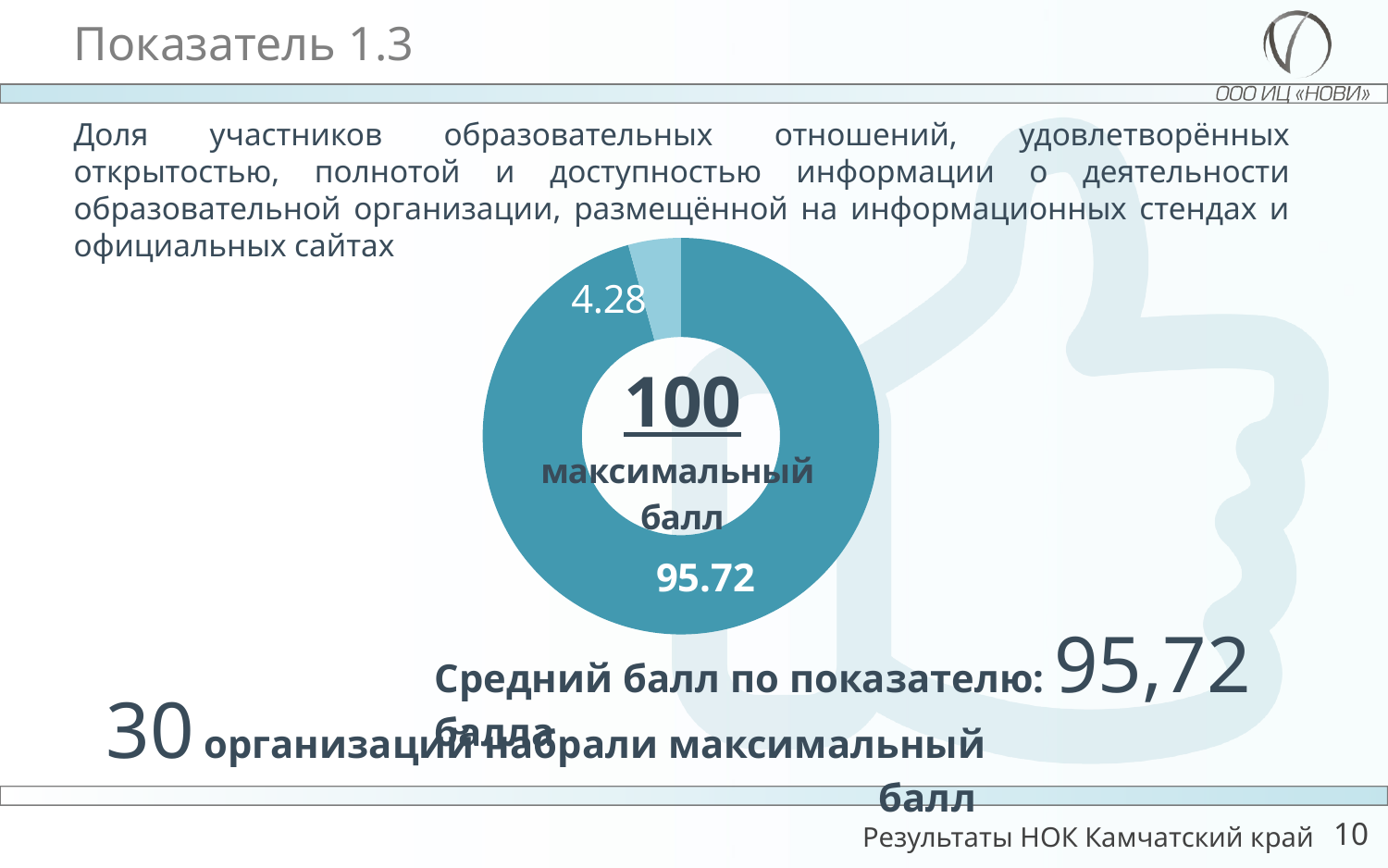
Which slice is larger on the doughnut chart, the dark teal one or the light teal one? the dark teal one How many slices does the doughnut chart have? 2 What is the total of the two slice values on the doughnut chart? 100 What value is labelled on the small light teal slice of the doughnut chart? 4.28 What is the smallest value shown on the doughnut chart? 4.28 What number is shown in the centre of the doughnut chart? 100 What share of the whole doughnut does the slice labelled 95.72 represent? 95.72% What is the difference between the two slice values on the doughnut chart? 91.44 What kind of chart is shown on the slide? doughnut (pie) chart What is the largest value shown on the doughnut chart? 95.72 What value is labelled on the large dark teal slice of the doughnut chart? 95.72 What text appears below the number in the centre of the doughnut chart? максимальный балл